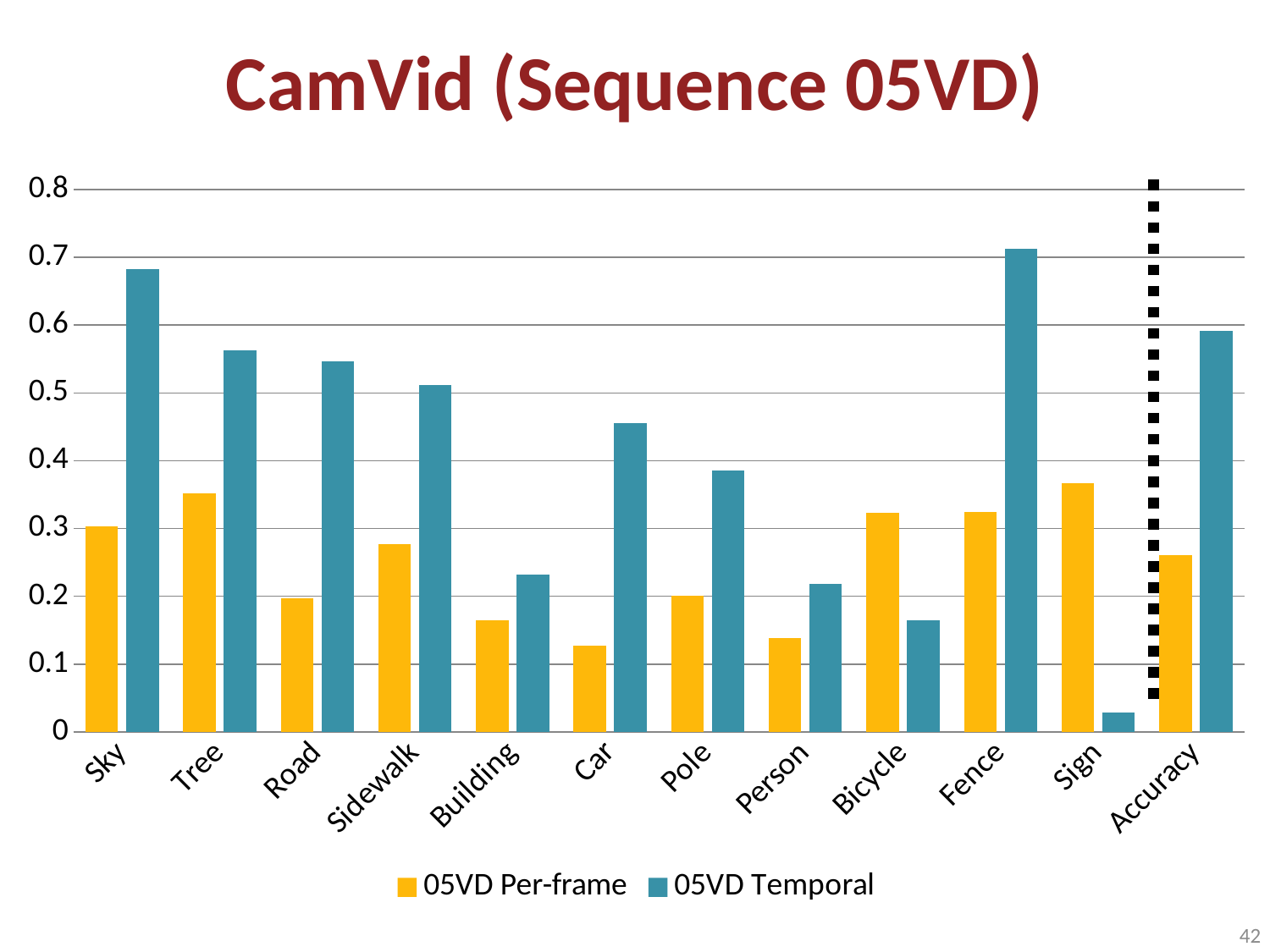
Is the 05VD Temporal value for Sky greater or less than 0.6? greater Which category has the lowest 05VD Temporal value? Sign Which is larger: the 05VD Temporal value for Sky or for Tree? Sky Is the 05VD Temporal value for Sign greater or less than 0.1? less Is the 05VD Per-frame value for Car greater or less than 0.2? less For Bicycle, which is larger: the 05VD Per-frame value or the 05VD Temporal value? 05VD Per-frame How many categories are shown along the x axis? 12 What is the title of the chart? CamVid (Sequence 05VD) Which category has the highest 05VD Temporal value? Fence How many series does the legend list? 2 What kind of chart is shown on the slide? bar chart